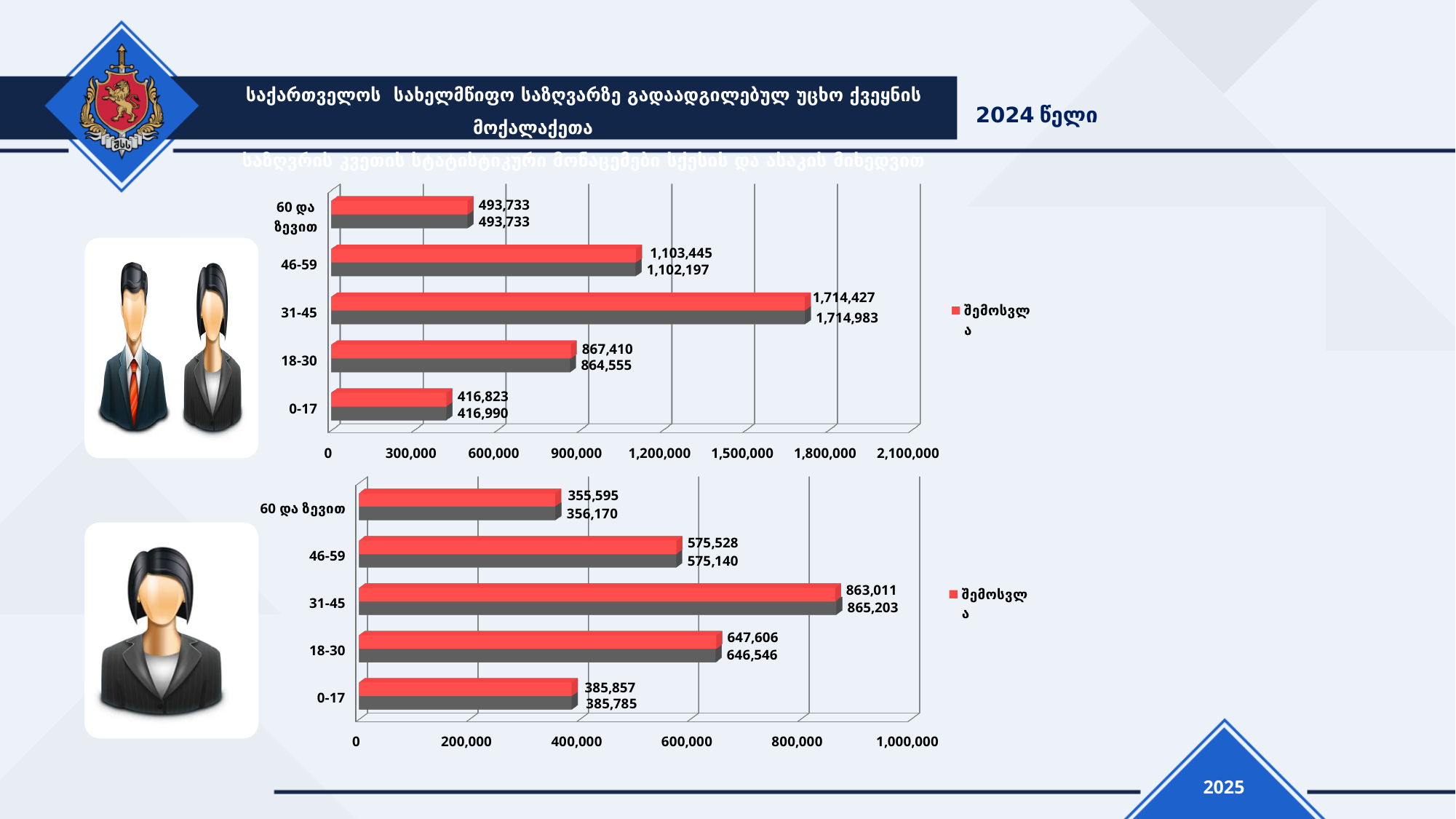
What type of chart is the top chart? bar chart On the bottom chart, what is the lower (grey bar) value for the 0-17 age group? 385,785 On the top chart, what is the difference between the red bar values for 46-59 and 60 და ზევით? 609,712 What is the highest axis tick shown on the bottom chart? 1,000,000 How many age categories are shown on the bottom chart? 5 On the bottom chart, which is larger: the red bar value for 18-30 or for 46-59? 18-30 On the top chart, which age group has the highest values? 31-45 On the bottom chart, what is the upper (red bar) value for the 46-59 age group? 575,528 On the top chart, what is the lower (grey bar) value for the 18-30 age group? 864,555 On the top chart, is the red bar value for 0-17 greater or less than 600,000? less On the bottom chart, which age group has the lowest values? 60 და ზევით On the top chart, what is the upper (red bar) value for the 31-45 age group? 1,714,427